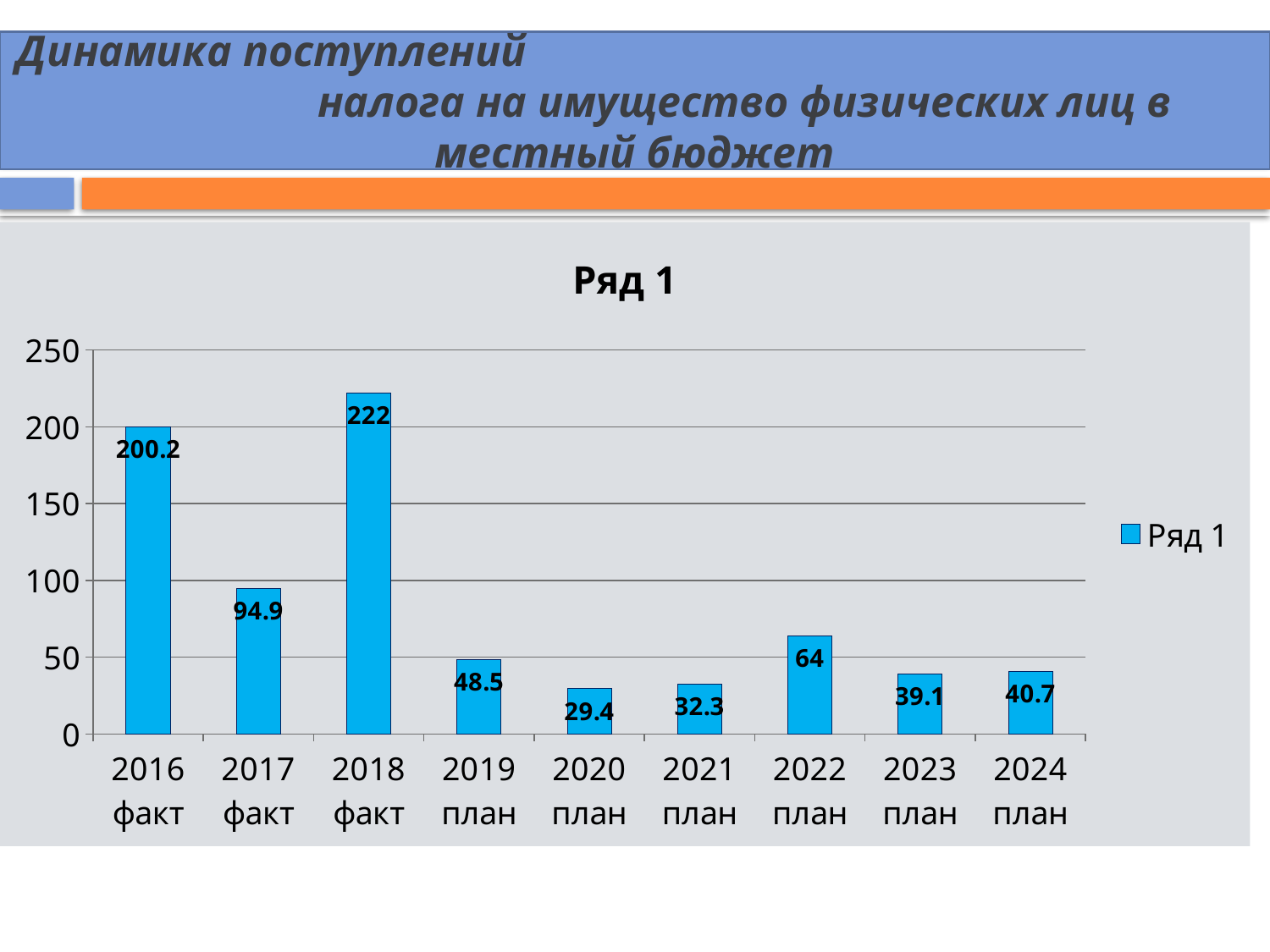
What is the name of the series shown in the legend? Ряд 1 Which category has the highest value? 2018 факт What is the value for 2020 план? 29.4 What is the difference between the values for 2018 факт and 2017 факт? 127.1 What kind of chart is shown on the slide? bar chart Which category has the lowest value? 2020 план Is the value for 2019 план greater or less than 50? less Which is larger, the value for 2023 план or the value for 2024 план? 2024 план What is the value for 2022 план? 64 How many series does the legend list? 1 How many categories are shown on the x axis? 9 What is the value for 2016 факт? 200.2